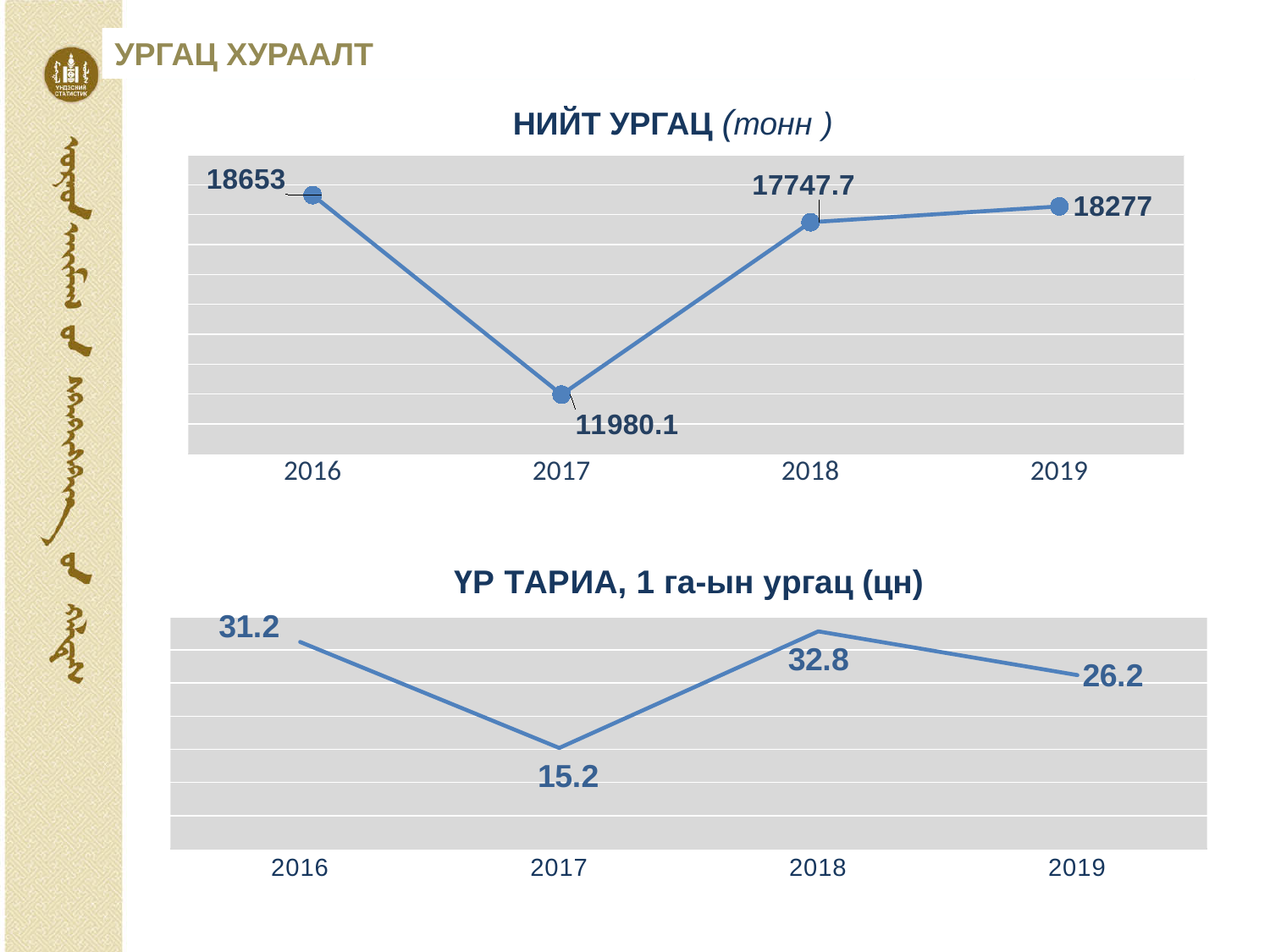
In the bottom chart 'ҮР ТАРИА, 1 га-ын ургац (цн)', what is the value for 2018? 32.8 In the bottom chart 'ҮР ТАРИА, 1 га-ын ургац (цн)', does the value rise or fall from 2018 to 2019? fall In the top chart 'НИЙТ УРГАЦ (тонн)', what is the value for 2019? 18277 In the bottom chart 'ҮР ТАРИА, 1 га-ын ургац (цн)', what is the difference between the 2018 and 2019 values? 6.6 In the top chart 'НИЙТ УРГАЦ (тонн)', which year has the highest value? 2016 In the top chart 'НИЙТ УРГАЦ (тонн)', how many years are plotted? 4 In the top chart 'НИЙТ УРГАЦ (тонн)', what is the value for 2017? 11980.1 What kind of chart is the bottom chart 'ҮР ТАРИА, 1 га-ын ургац (цн)'? line chart In the top chart 'НИЙТ УРГАЦ (тонн)', which year has the lowest value? 2017 In the top chart 'НИЙТ УРГАЦ (тонн)', what is the difference between the 2016 and 2017 values? 6672.9 In the top chart 'НИЙТ УРГАЦ (тонн)', is the value for 2018 or 2019 larger? 2019 In the bottom chart 'ҮР ТАРИА, 1 га-ын ургац (цн)', which year has the lowest value? 2017